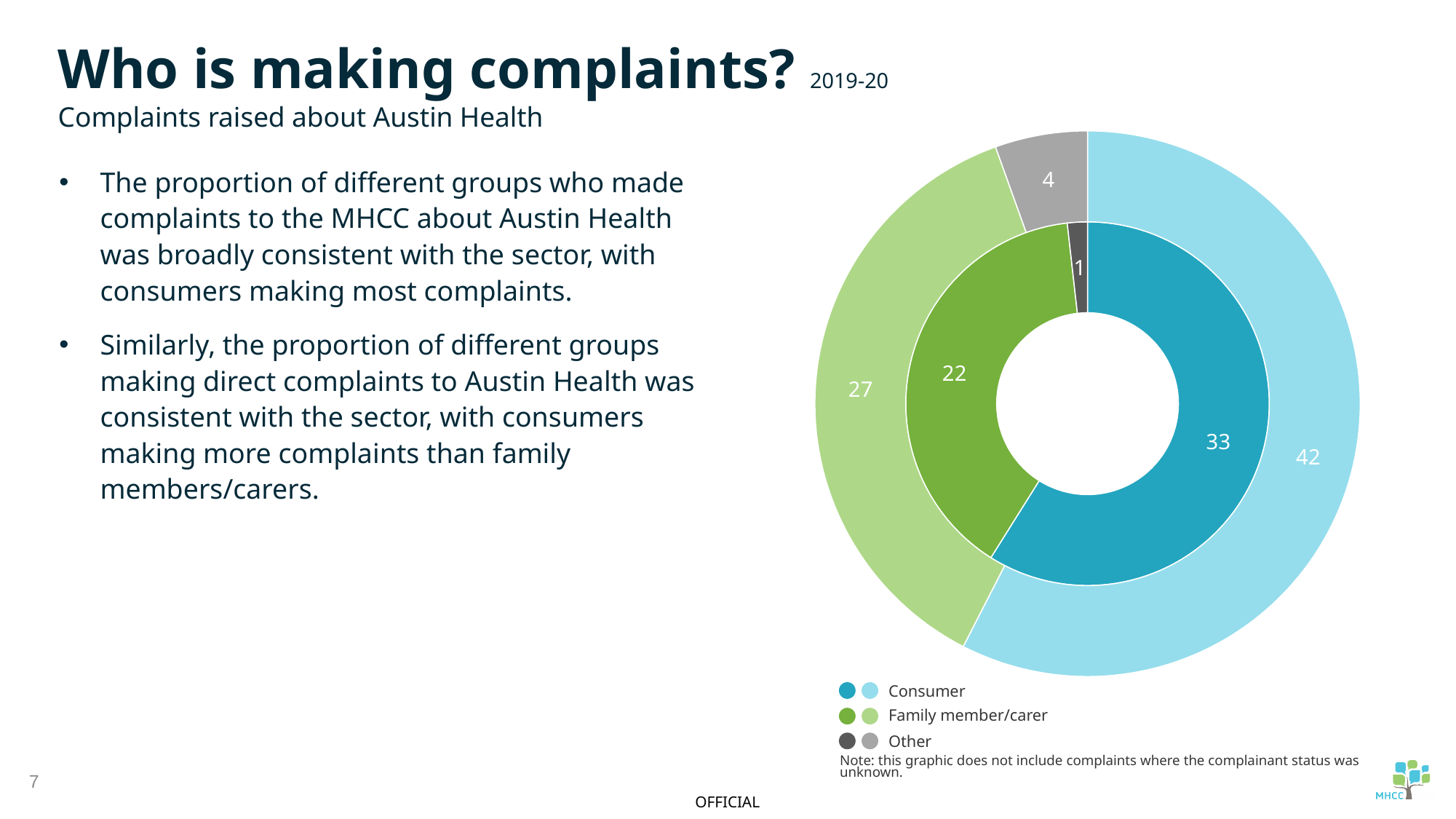
In the outer ring of the doughnut chart, what is the value for Other? 4 What kind of chart is shown on the slide? Doughnut chart Which category has the smallest value in the outer ring of the doughnut chart? Other In the outer ring of the doughnut chart, what is the value for Family member/carer? 27 In the outer ring of the doughnut chart, what is the value for Consumer? 42 In the inner ring of the doughnut chart, what is the value for Consumer? 33 Which category has the largest value in the inner ring of the doughnut chart? Consumer How many categories does the legend of the doughnut chart list? 3 In the outer ring, what is the difference between the Consumer value and the Family member/carer value? 15 In the inner ring of the doughnut chart, what is the value for Other? 1 What is the total of the values shown in the inner ring of the doughnut chart? 56 In the inner ring, which is larger: the value for Consumer or the value for Family member/carer? Consumer